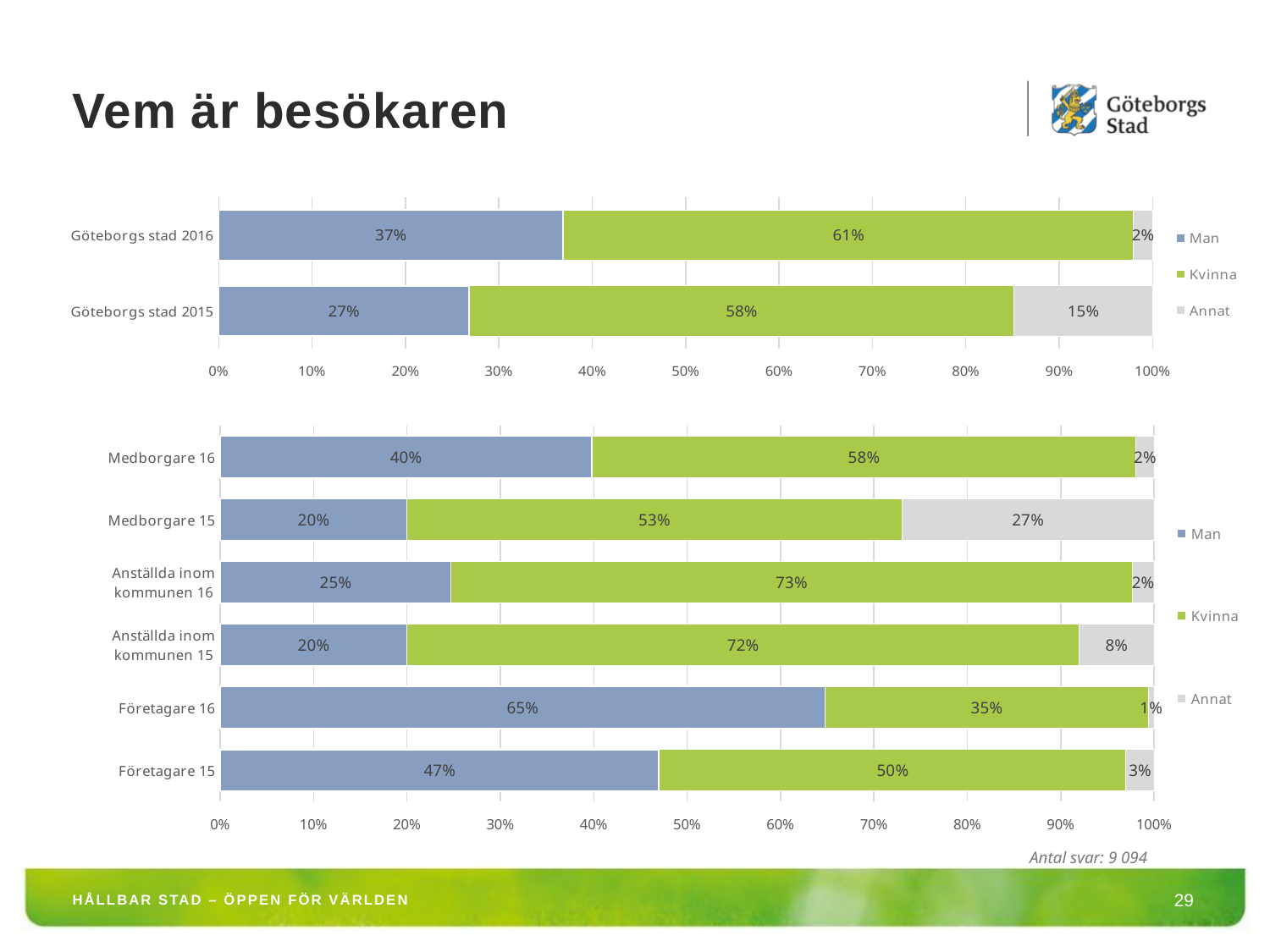
In the bottom chart, what is the Kvinna value for Anställda inom kommunen 16? 73% In the bottom chart, which category has the highest Man value? Företagare 16 In the bottom chart, what is the difference between the Man values for Medborgare 16 and Medborgare 15? 20 percentage points In the top chart, what is the difference between the Kvinna values for Göteborgs stad 2016 and Göteborgs stad 2015? 3 percentage points What kind of chart is the bottom chart? Stacked bar chart In the bottom chart, which category has the highest Annat value? Medborgare 15 In the bottom chart, which is larger: the Man value for Medborgare 16 or the Man value for Företagare 15? Företagare 15 In the bottom chart, what is the Man value for Företagare 16? 65% In the top chart, what is the Annat value for Göteborgs stad 2015? 15% In the top chart, how many series does the legend list? 3 In the bottom chart, how many categories are shown? 6 In the top chart, what is the Man value for Göteborgs stad 2016? 37%